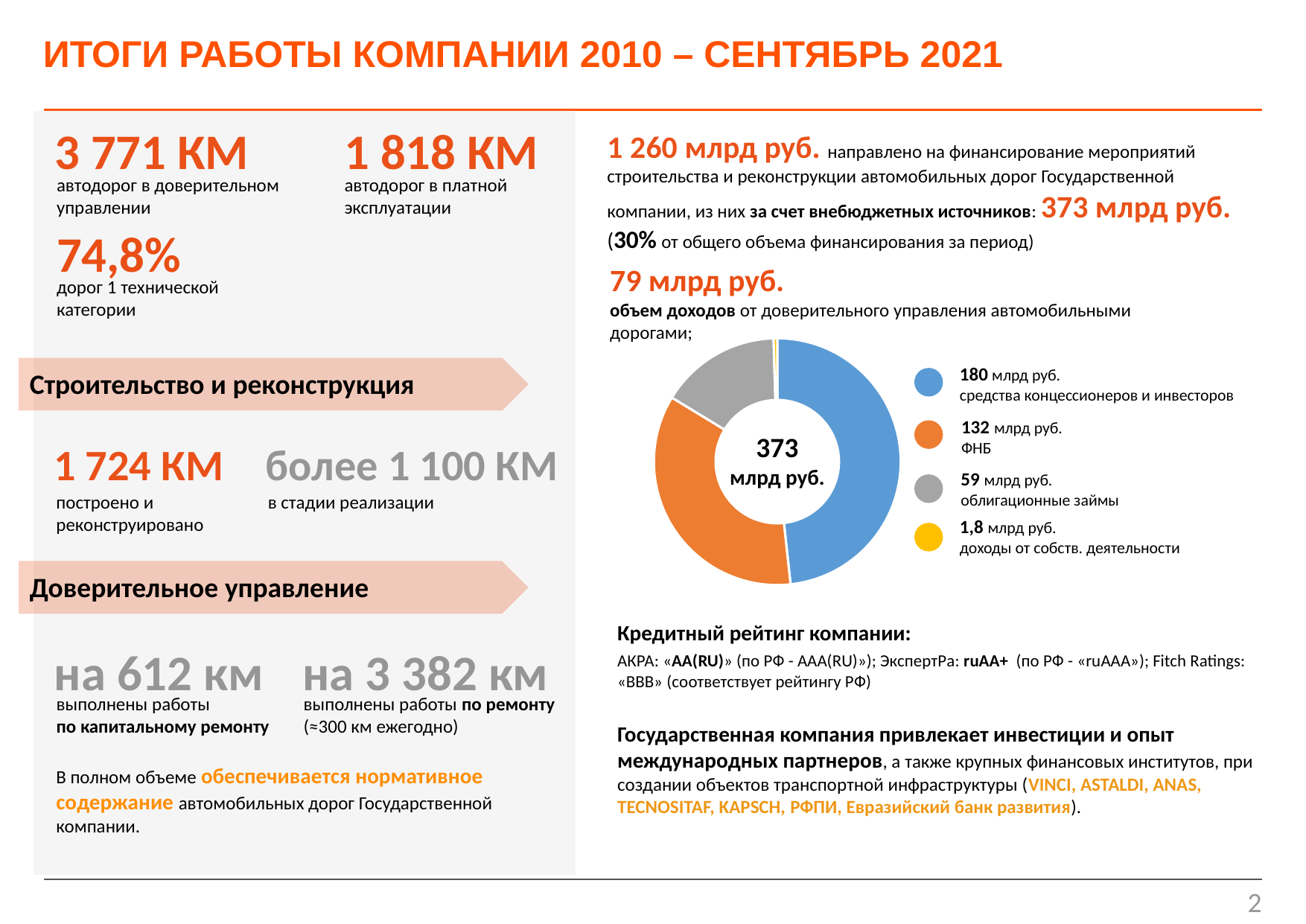
What value is shown for доходы от собств. деятельности in the donut chart? 1,8 млрд руб. What colour represents ФНБ in the donut chart? Orange What kind of chart is shown on the slide? Donut (pie) chart What value is shown for ФНБ in the donut chart? 132 млрд руб. How many categories does the donut chart show? 4 What is the difference between средства концессионеров и инвесторов and ФНБ in the donut chart? 48 млрд руб. What total is shown in the centre of the donut chart? 373 млрд руб. What value is shown for средства концессионеров и инвесторов in the donut chart? 180 млрд руб. What value is shown for облигационные займы in the donut chart? 59 млрд руб. Which category has the smallest value in the donut chart? доходы от собств. деятельности Which category has the largest value in the donut chart? средства концессионеров и инвесторов Which is larger in the donut chart: ФНБ or облигационные займы? ФНБ